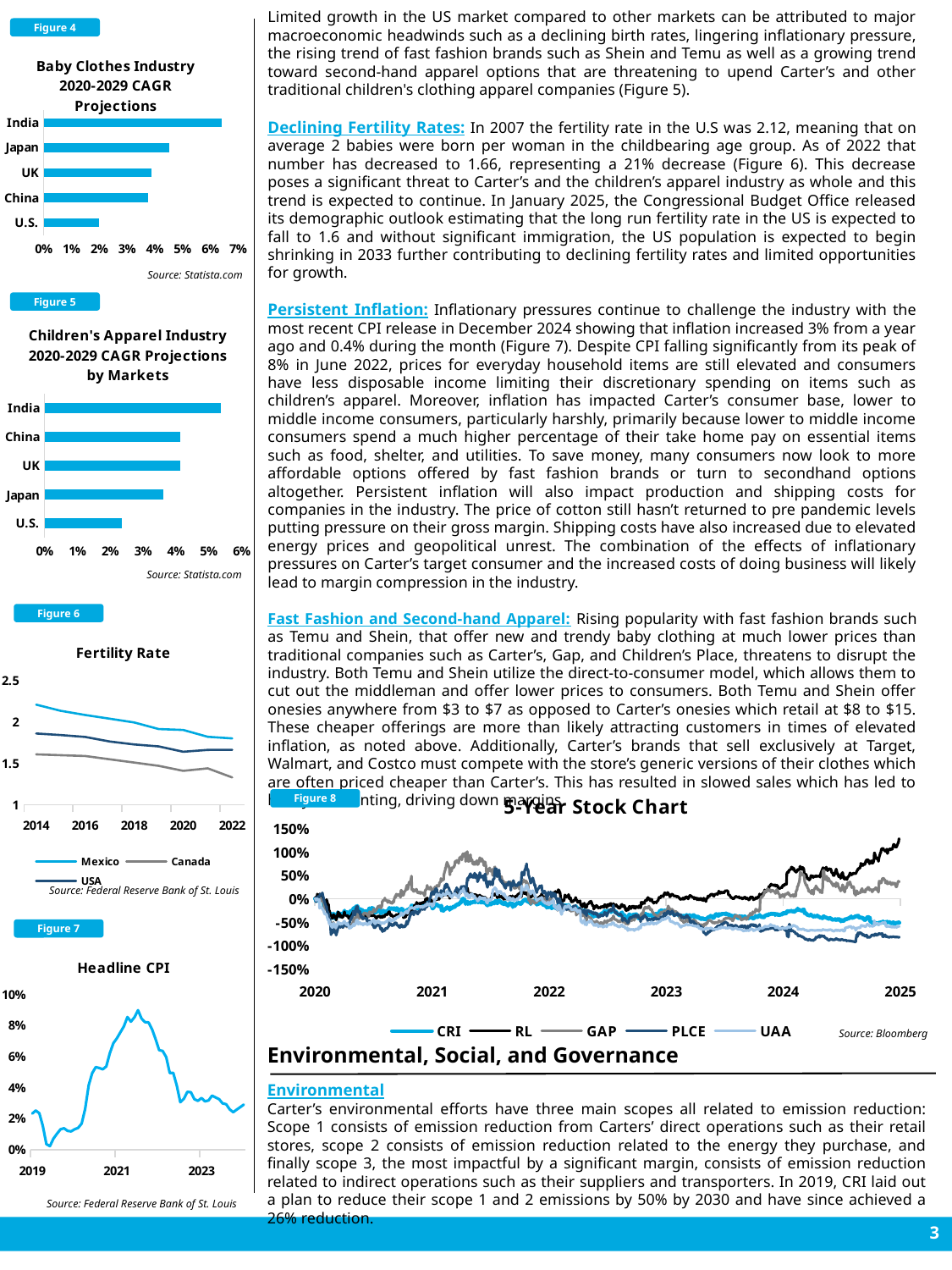
In the Children's Apparel Industry 2020-2029 CAGR Projections by Markets chart (Figure 5), is the value for the U.S. greater or less than 3%? less In the Fertility Rate chart (Figure 6), does the Mexico line rise or fall from 2014 to 2022? fall In the Baby Clothes Industry 2020-2029 CAGR Projections chart (Figure 4), is the value for India greater or less than 6%? greater In the Baby Clothes Industry 2020-2029 CAGR Projections chart (Figure 4), which country has the lowest projected CAGR? U.S. How many countries are shown in the Children's Apparel Industry 2020-2029 CAGR Projections by Markets chart (Figure 5)? 5 In the Baby Clothes Industry 2020-2029 CAGR Projections chart (Figure 4), which is larger, the value for Japan or the value for the U.S.? Japan In the 5-Year Stock Chart (Figure 8), which series has the highest value at the end of the chart in 2025? RL How many series does the legend of the Fertility Rate chart (Figure 6) list? 3 In the Children's Apparel Industry 2020-2029 CAGR Projections by Markets chart (Figure 5), which country has the lowest projected CAGR? U.S. In the Headline CPI chart (Figure 7), is the peak value greater or less than 8%? greater What kind of chart is the Children's Apparel Industry 2020-2029 CAGR Projections by Markets chart (Figure 5)? bar chart In the Baby Clothes Industry 2020-2029 CAGR Projections chart (Figure 4), which country has the highest projected CAGR? India